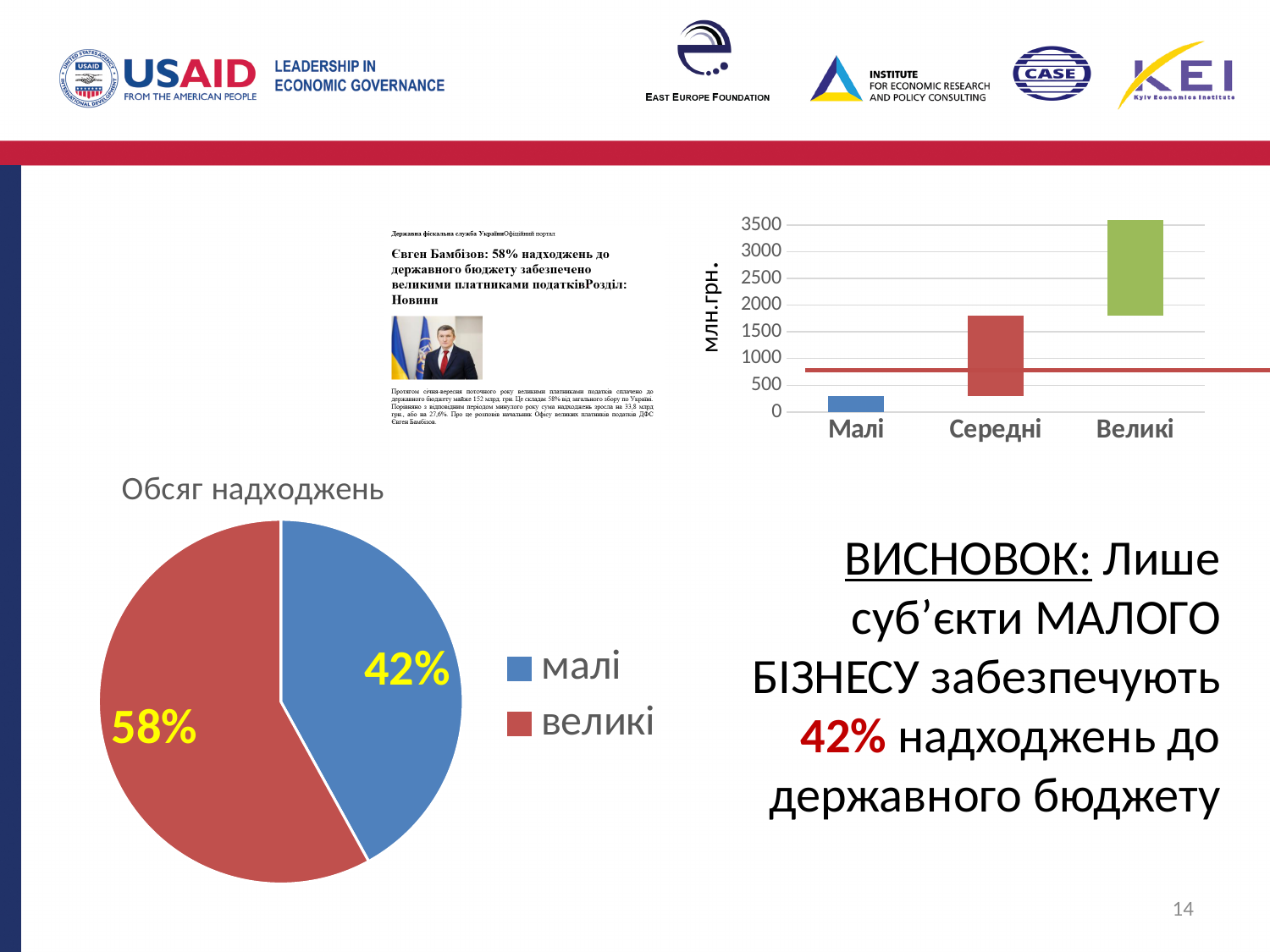
In the bar chart at the top right of the slide, which category's bar reaches the highest value? Великі What kind of chart is the chart titled 'Обсяг надходжень'? pie chart In the pie chart 'Обсяг надходжень', how many slices are there? 2 In the bar chart at the top right of the slide, what is the label on the vertical axis? млн.грн. In the pie chart 'Обсяг надходжень', what is the difference in percentage points between великі and малі? 16% In the pie chart 'Обсяг надходжень', what share is shown for великі? 58% In the bar chart at the top right of the slide, is the top of the bar for Малі greater or less than 500? less In the pie chart 'Обсяг надходжень', which slice is the largest? великі In the pie chart 'Обсяг надходжень', what share is shown for малі? 42% In the pie chart 'Обсяг надходжень', how many entries does the legend list? 2 In the pie chart 'Обсяг надходжень', which slice is the smallest? малі In the bar chart at the top right of the slide, how many categories are shown on the x axis? 3